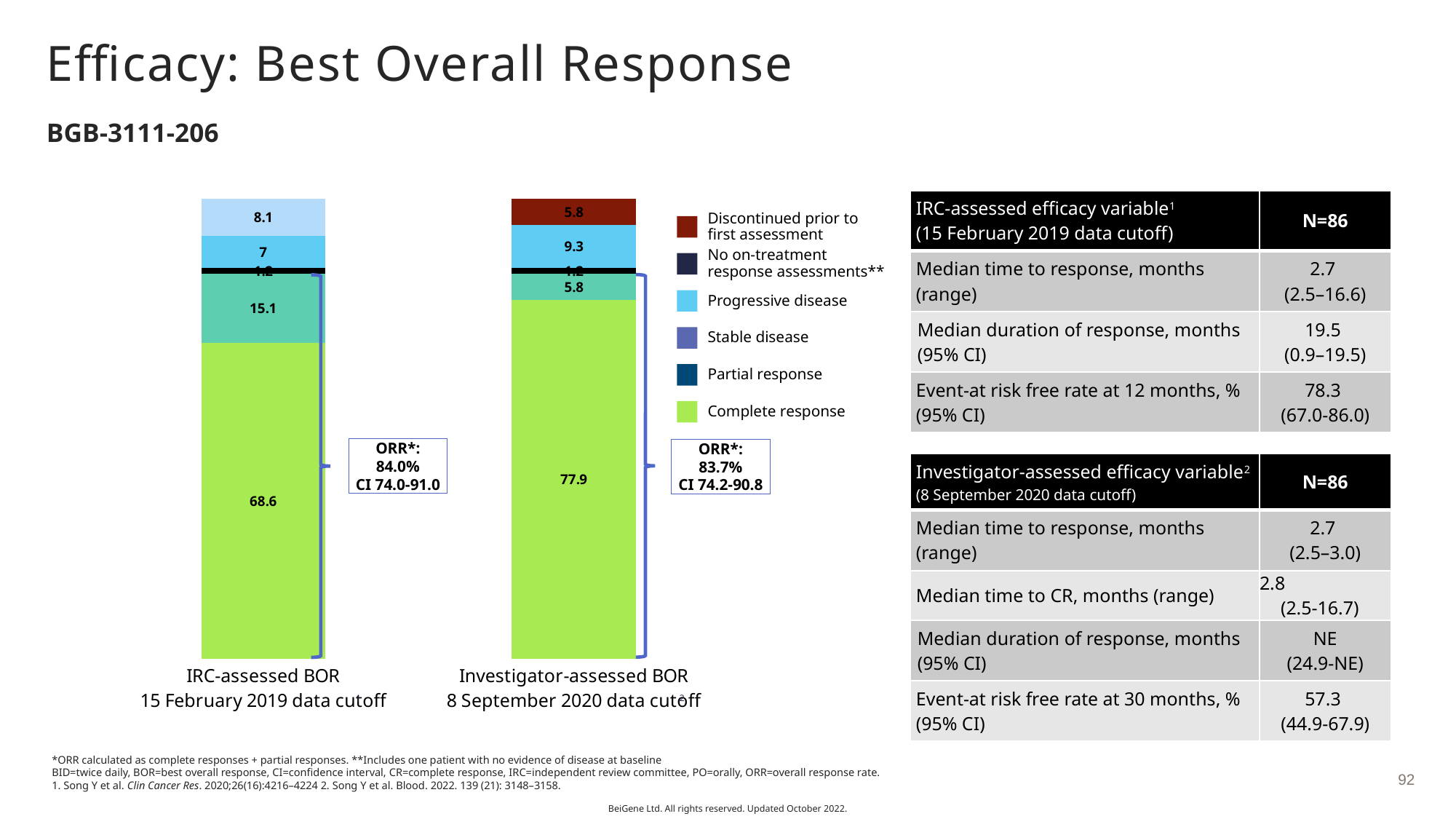
What kind of chart is shown on the left side of the slide? Stacked bar chart What is the complete response value in the Investigator-assessed BOR bar? 77.9 What is the difference between the complete response values of the Investigator-assessed BOR bar and the IRC-assessed BOR bar? 9.3 What ORR is shown next to the Investigator-assessed BOR bar? 83.7% What is the value of the topmost segment of the Investigator-assessed BOR bar? 5.8 What is the value of the topmost segment of the IRC-assessed BOR bar? 8.1 How many entries does the legend of the best overall response chart list? 6 What is the largest segment value in the IRC-assessed BOR bar? 68.6 How many bars are plotted in the best overall response chart? 2 What ORR is shown next to the IRC-assessed BOR bar? 84.0% Which bar has the larger complete response segment, IRC-assessed BOR or Investigator-assessed BOR? Investigator-assessed BOR What is the complete response value in the IRC-assessed BOR bar? 68.6